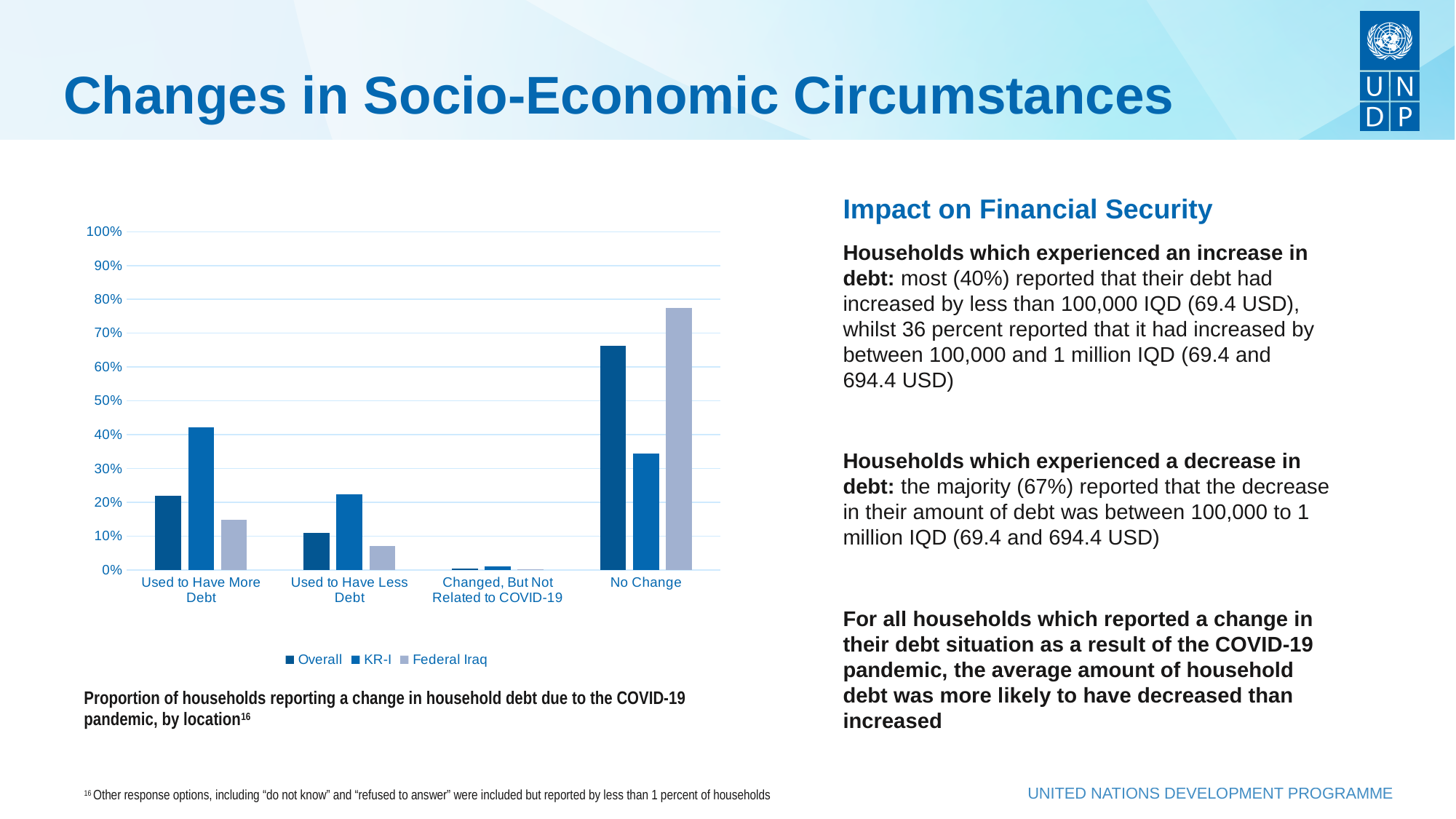
Is the Federal Iraq value for No Change greater or less than 70%? greater For No Change, which is larger: the Overall value or the KR-I value? Overall How many series does the chart's legend list? 3 For the Federal Iraq series, which category has the highest bar? No Change Is the Overall value for No Change greater or less than 60%? greater Is the KR-I value for Used to Have More Debt greater or less than 30%? greater Which series are listed in the chart's legend? Overall, KR-I, Federal Iraq For Used to Have More Debt, which is larger: the KR-I value or the Federal Iraq value? KR-I How many categories are shown on the x axis of the chart? 4 What kind of chart is shown on the slide? bar chart For the Overall series, which category has the lowest bar? Changed, But Not Related to COVID-19